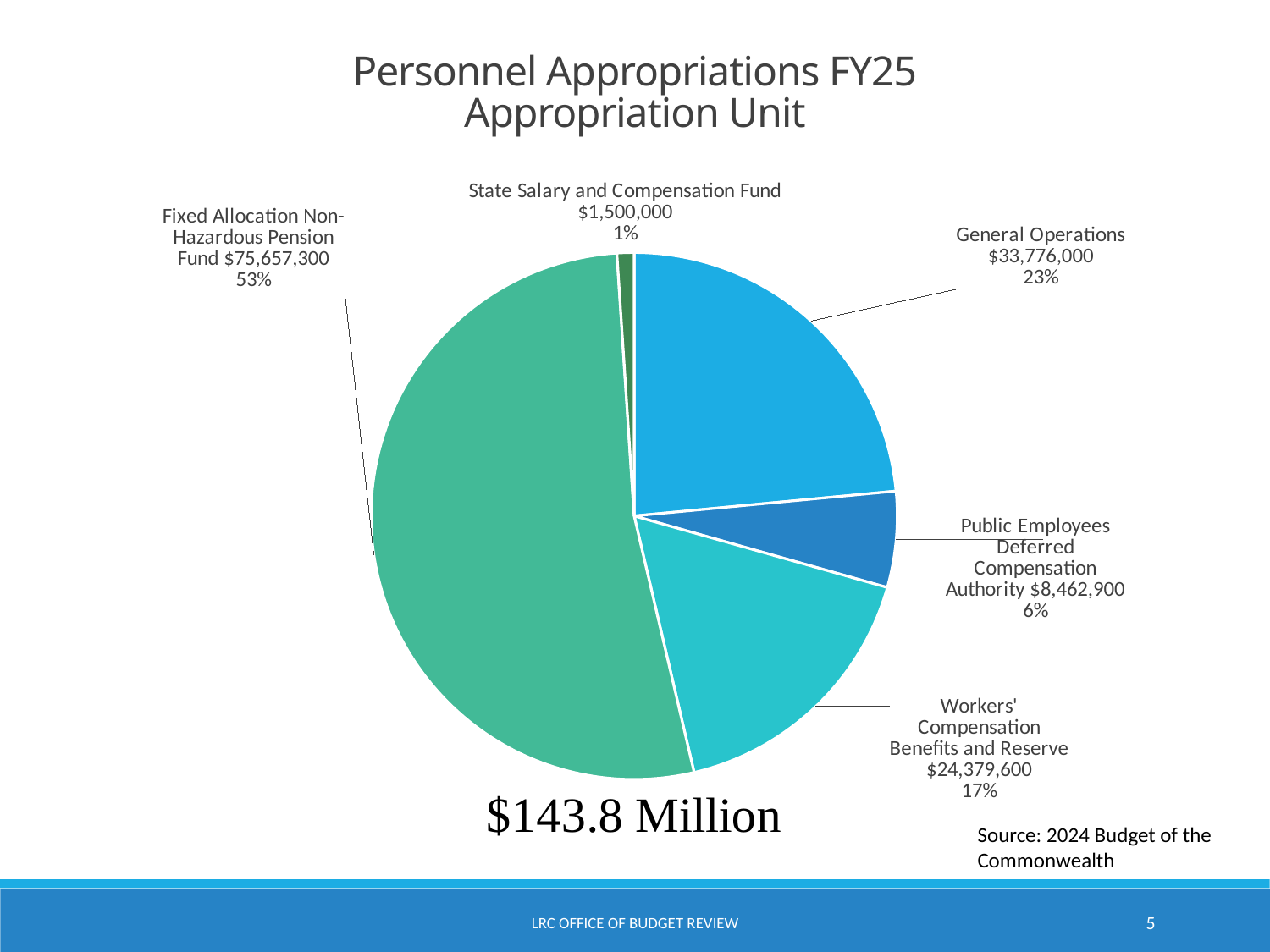
Which appropriation unit has the smallest share of the pie? State Salary and Compensation Fund How many slices does the pie chart have? 5 What percentage share of the pie does the Fixed Allocation Non-Hazardous Pension Fund represent? 53% What percentage share of the pie does General Operations represent? 23% Which appropriation unit has the largest share of the pie? Fixed Allocation Non-Hazardous Pension Fund What is the value for the Public Employees Deferred Compensation Authority? $8,462,900 What is the difference between the General Operations value and the Workers' Compensation Benefits and Reserve value? $9,396,400 Which is larger, General Operations or Workers' Compensation Benefits and Reserve? General Operations What total amount is printed below the pie chart? $143.8 Million What type of chart is shown on the slide? Pie chart What is the value for Workers' Compensation Benefits and Reserve? $24,379,600 What is the value for General Operations? $33,776,000